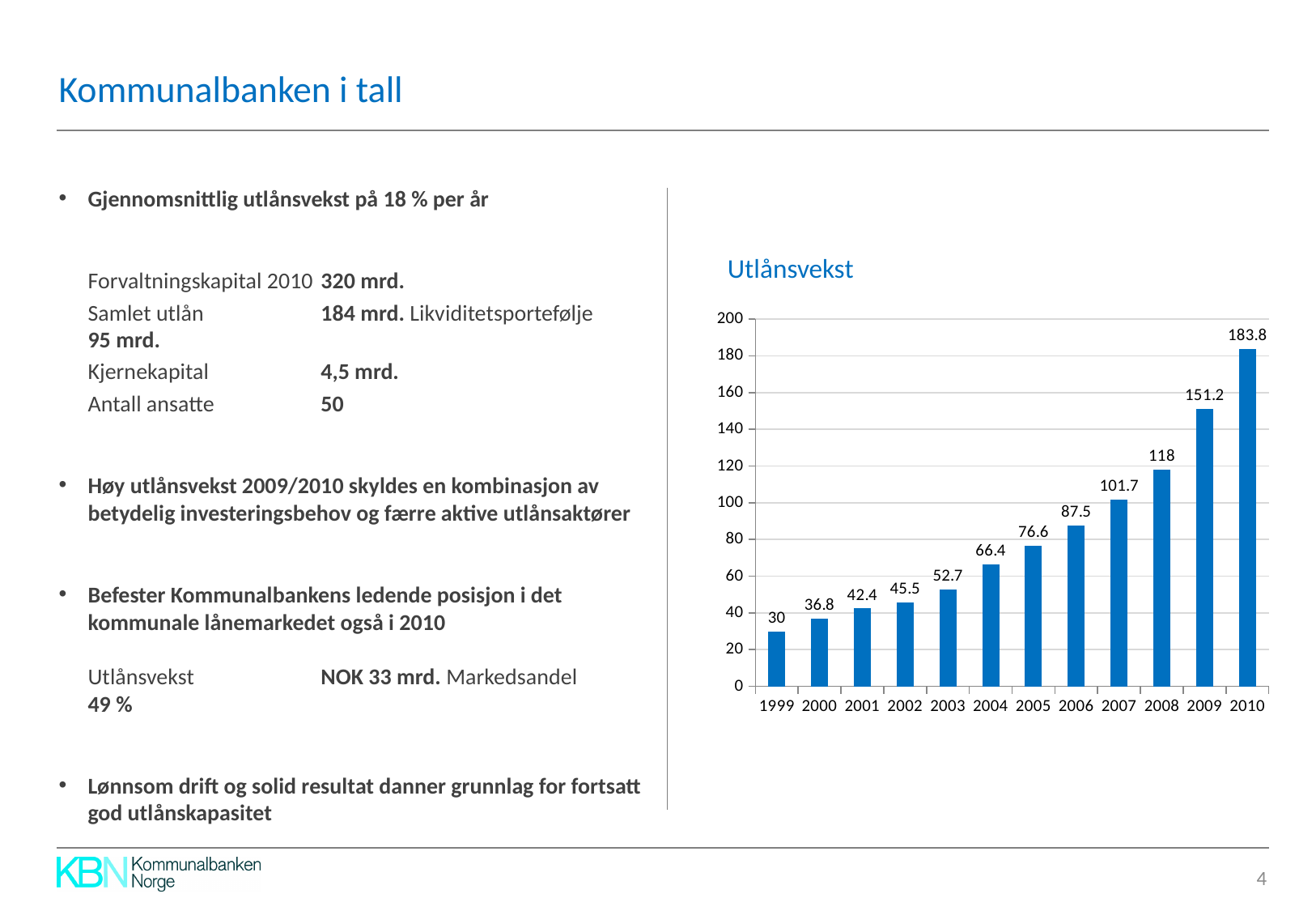
What kind of chart is the Utlånsvekst chart? bar chart What is the value for 2007 in the Utlånsvekst chart? 101.7 Which year has the lowest value in the Utlånsvekst chart? 1999 Do the values in the Utlånsvekst chart rise or fall from 1999 to 2010? rise Is the value for 2009 in the Utlånsvekst chart greater or less than 140? greater What is the difference between the values for 2008 and 2007 in the Utlånsvekst chart? 16.3 How many years are shown on the x axis of the Utlånsvekst chart? 12 What is the difference between the values for 2010 and 2009 in the Utlånsvekst chart? 32.6 What is the value for 2010 in the Utlånsvekst chart? 183.8 What is the value for 1999 in the Utlånsvekst chart? 30 Which is larger in the Utlånsvekst chart, the value for 2005 or the value for 2003? 2005 Which year has the highest value in the Utlånsvekst chart? 2010